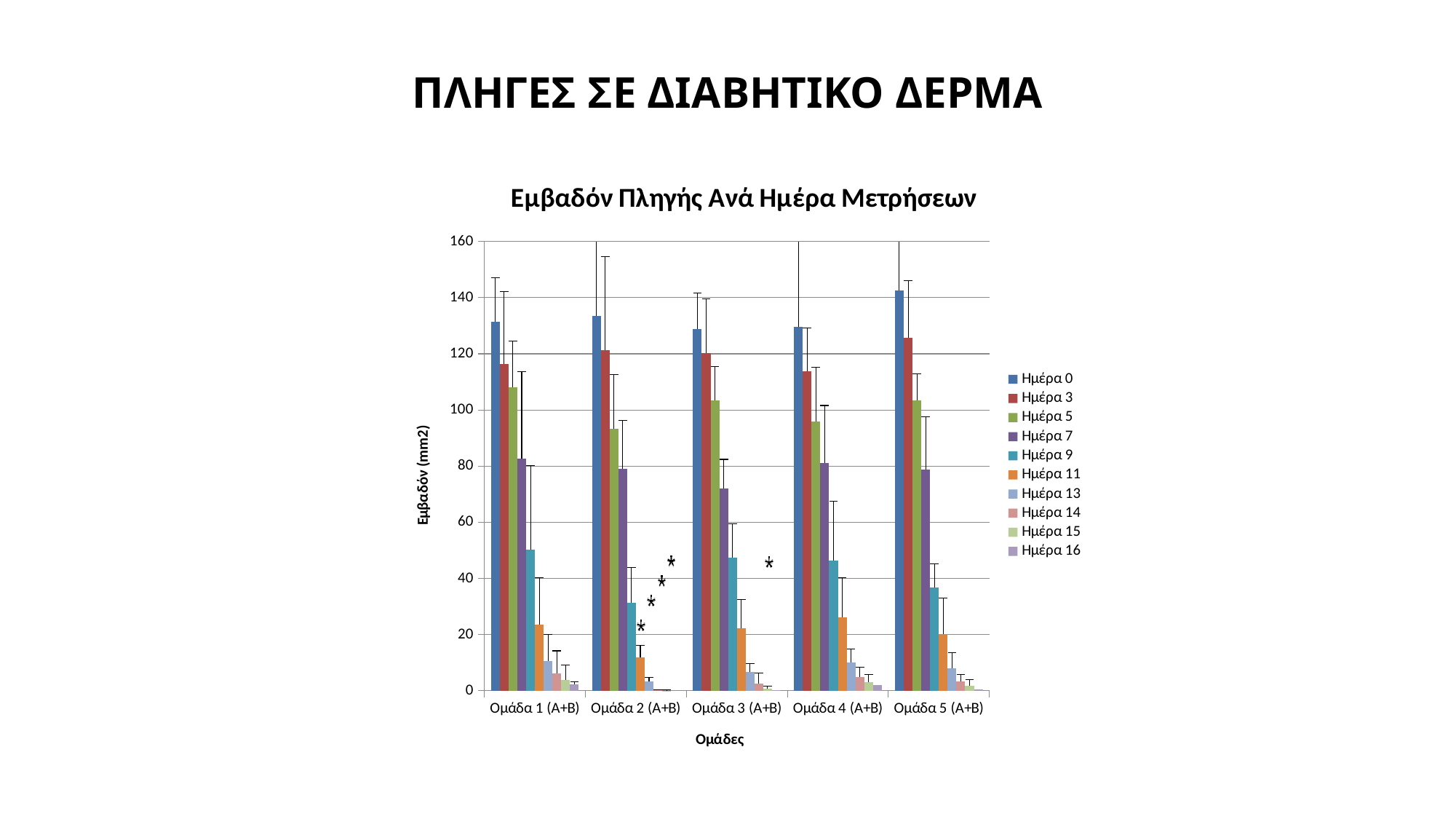
Which group has the lowest value for Ημέρα 9? Ομάδα 2 (A+B) What kind of chart is shown on the slide? bar chart How many series does the legend list? 10 Which is larger: the Ημέρα 3 value for Ομάδα 5 (A+B) or for Ομάδα 1 (A+B)? Ομάδα 5 (A+B) Is the value for Ημέρα 0 in Ομάδα 1 (A+B) greater or less than 120? greater How many groups (categories) are shown on the x axis? 5 Is the value for Ημέρα 5 in Ομάδα 2 (A+B) greater or less than 100? less What is the label of the vertical axis? Εμβαδόν (mm2) What is the title of the chart? Εμβαδόν Πληγής Ανά Ημέρα Μετρήσεων Which group has the highest value for Ημέρα 0? Ομάδα 5 (A+B) Within each group, do the values rise or fall as the measurement day increases from Ημέρα 0 to Ημέρα 16? fall Is the value for Ημέρα 7 in Ομάδα 3 (A+B) greater or less than 80? less